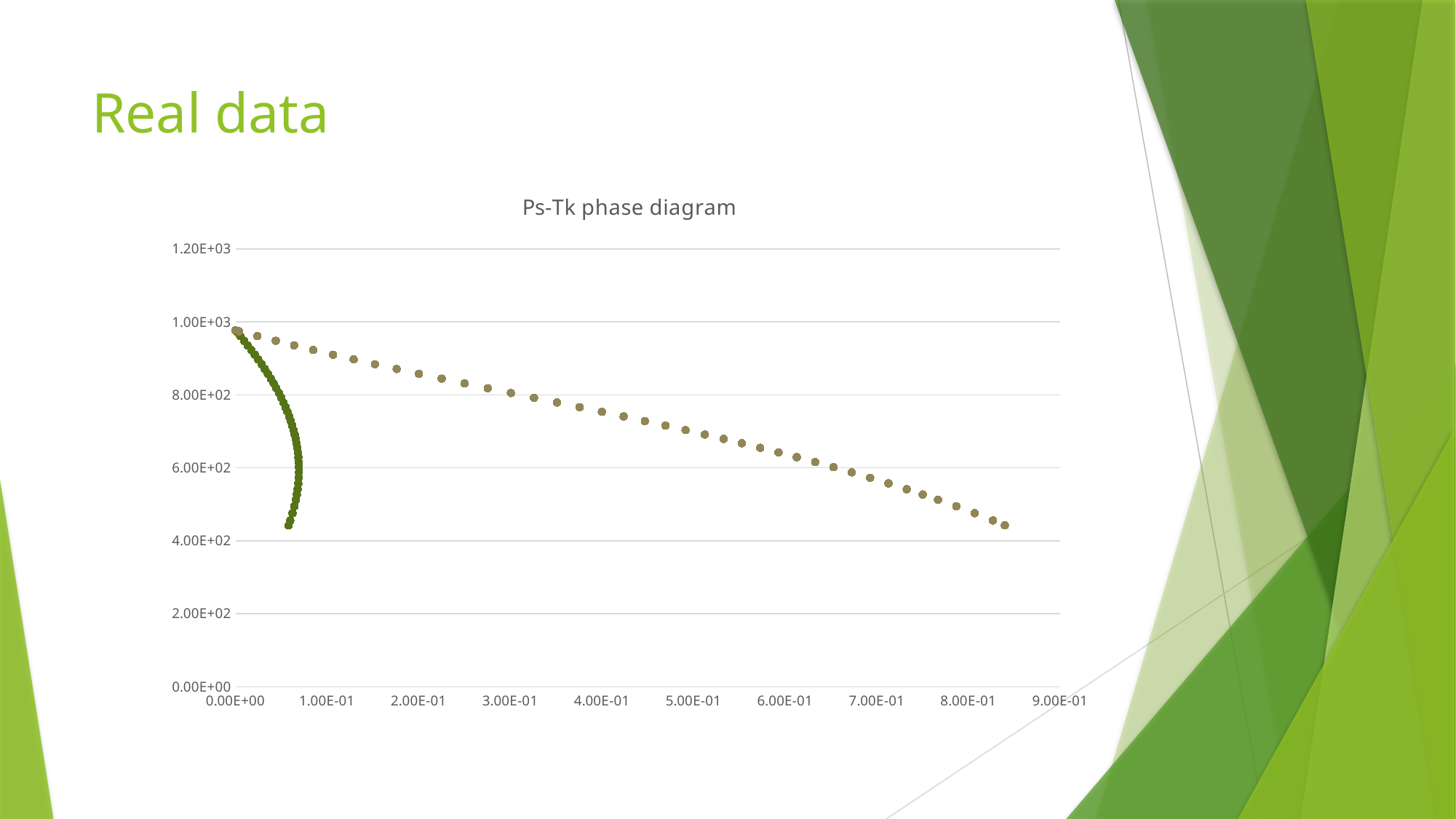
What is the highest tick label shown on the y axis? 1.20E+03 Is the y value of the lowest point of the dark green series greater or less than 4.00E+02? greater What is the title of the chart? Ps-Tk phase diagram What kind of chart is shown on the slide? scatter chart Do the y values of the lighter (olive) series rise or fall as the x value increases? fall Is the x value of the rightmost point on the chart greater or less than 8.00E-01? greater Is the y value of the topmost point on the chart greater or less than 8.00E+02? greater